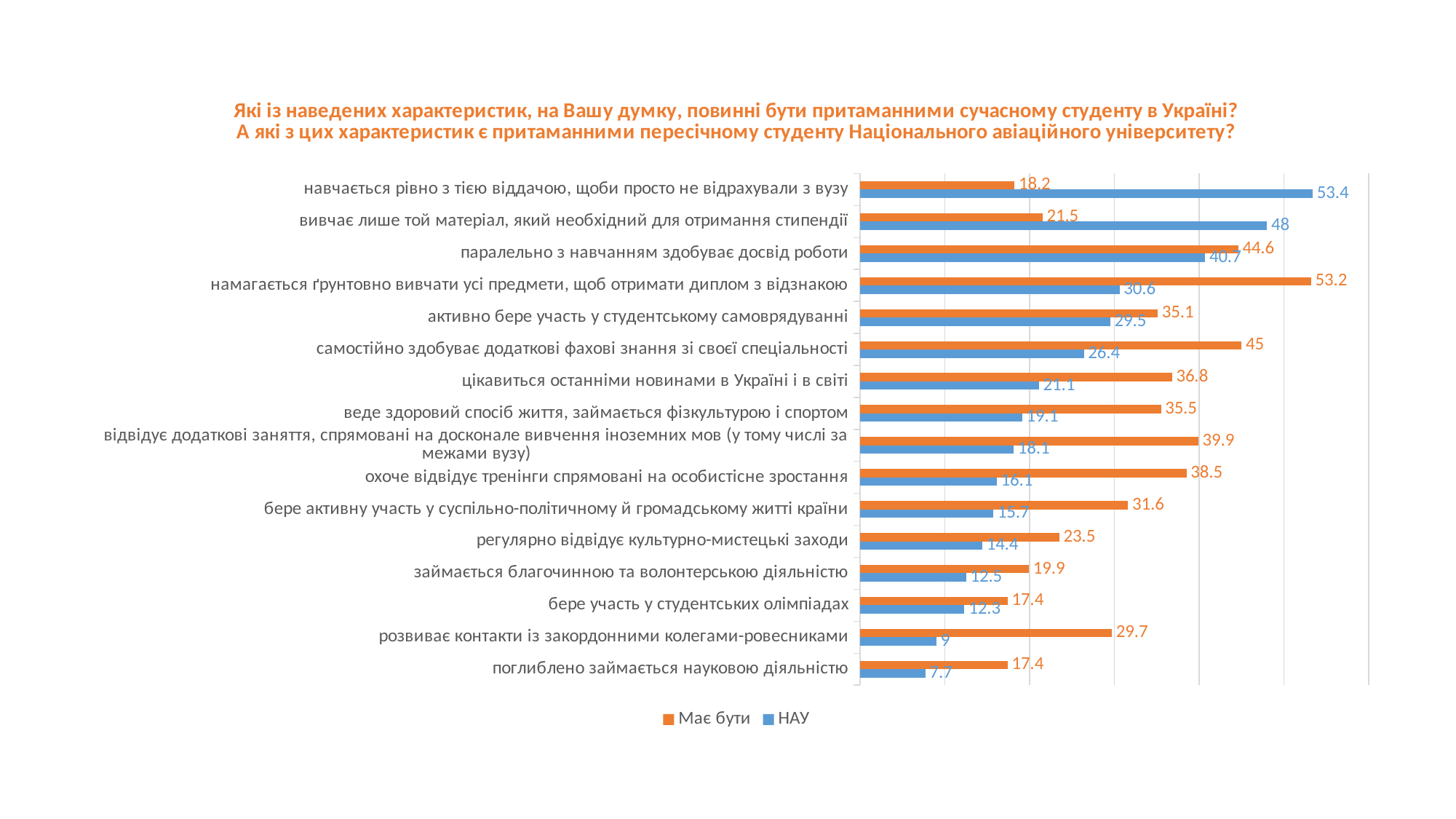
What is the value of the "Має бути" series for "самостійно здобуває додаткові фахові знання зі своєї спеціальності"? 45 Which category has the highest value in the "Має бути" series? намагається ґрунтовно вивчати усі предмети, щоб отримати диплом з відзнакою For "навчається рівно з тією віддачою, щоби просто не відрахували з вузу", which series has the larger value, "Має бути" or НАУ? НАУ Which category has the lowest value in the НАУ series? поглиблено займається науковою діяльністю How many categories are plotted on the chart? 16 How many series does the legend list? 2 Which category has the highest value in the НАУ series? навчається рівно з тією віддачою, щоби просто не відрахували з вузу What kind of chart is shown on the slide? bar chart What is the value of the НАУ series for "вивчає лише той матеріал, який необхідний для отримання стипендії"? 48 What is the value of the НАУ series for "поглиблено займається науковою діяльністю"? 7.7 What is the difference between the "Має бути" and НАУ values for "розвиває контакти із закордонними колегами-ровесниками"? 20.7 Which series is shown in orange in the legend? Має бути